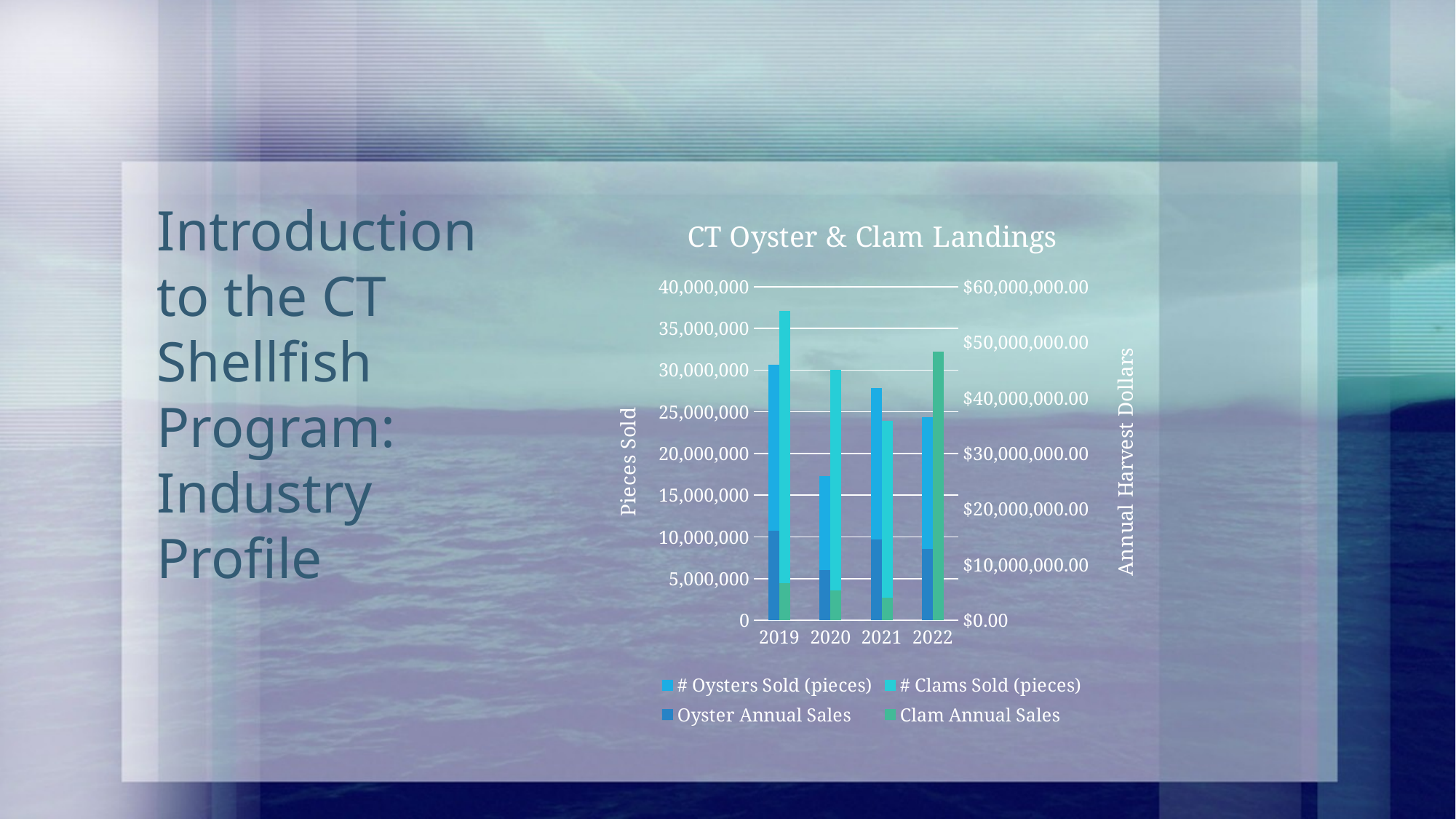
In 2020, which is larger: # Oysters Sold (pieces) or # Clams Sold (pieces)? # Clams Sold (pieces) In which year is the # Oysters Sold (pieces) value lowest? 2020 What kind of chart is shown on the slide? bar chart Is the # Oysters Sold (pieces) value for 2020 greater or less than 20,000,000? less What is the title of the chart? CT Oyster & Clam Landings Does the # Clams Sold (pieces) value rise or fall from 2019 to 2021? fall In which year is the # Clams Sold (pieces) value highest? 2019 What is the label of the right-hand vertical axis? Annual Harvest Dollars How many series does the chart's legend list? 4 Is the # Clams Sold (pieces) value for 2019 greater or less than 35,000,000? greater How many years are shown on the x axis of the chart? 4 In which year is the Clam Annual Sales value highest? 2022